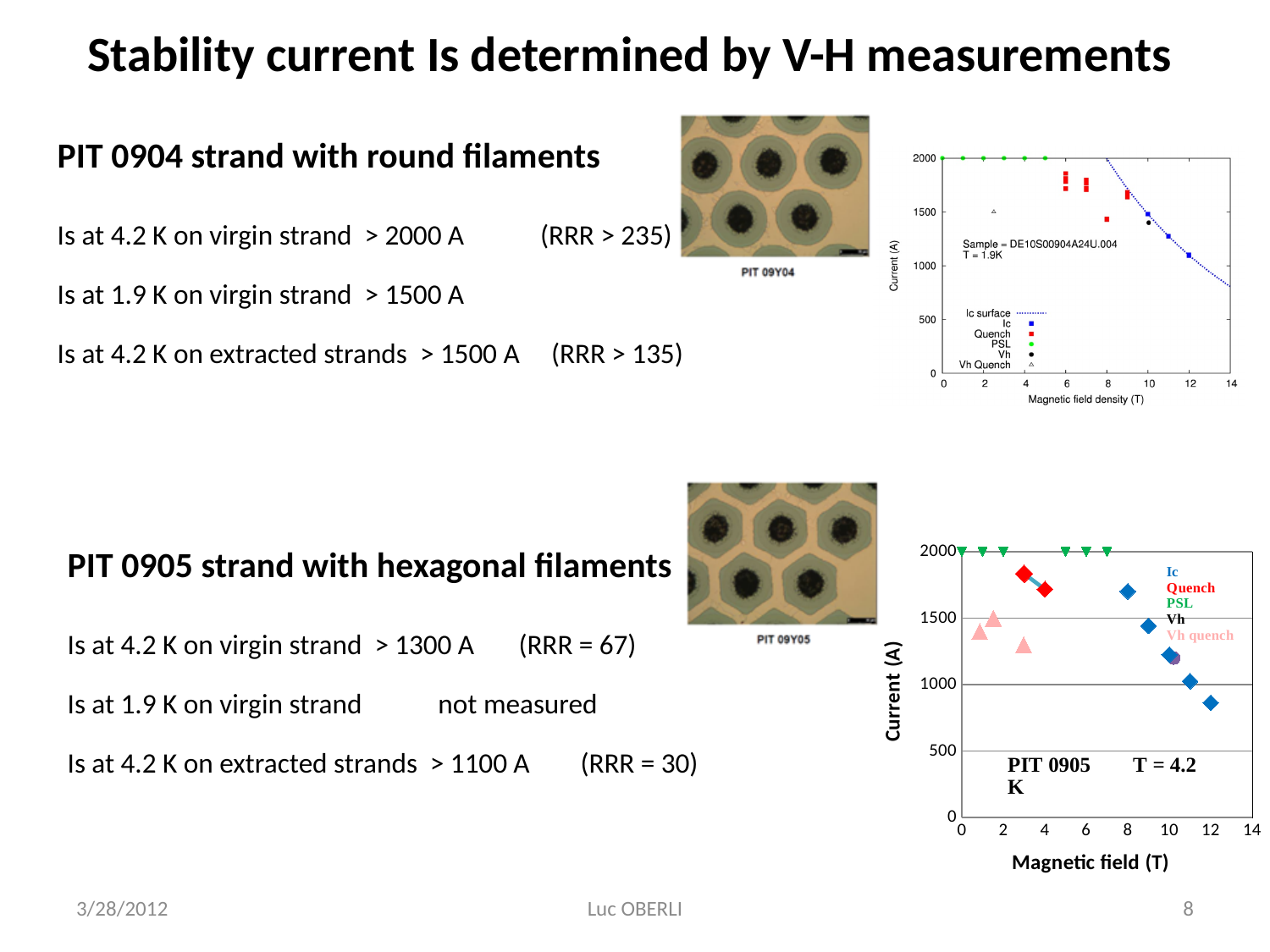
What is the x-axis title of the bottom-right chart (PIT 0905)? Magnetic field (T) In the top-right chart (T = 1.9K), is the Ic value at 12 T greater or less than 1500? less In the bottom-right chart (PIT 0905), is the Ic value at 8 T greater or less than 1500? greater In the bottom-right chart (PIT 0905), which is larger: the Ic value at 8 T or the Ic value at 12 T? Ic at 8 T How many entries does the legend of the top-right chart (T = 1.9K) list? 6 In the bottom-right chart (PIT 0905), do the Ic values rise or fall as the magnetic field increases? fall In the bottom-right chart (PIT 0905), is the Ic value at 12 T greater or less than 1000? less What kind of chart is the bottom-right chart (PIT 0905)? scatter chart In the bottom-right chart (PIT 0905), what colour are the Ic markers? blue How many series does the legend of the bottom-right chart (PIT 0905) list? 5